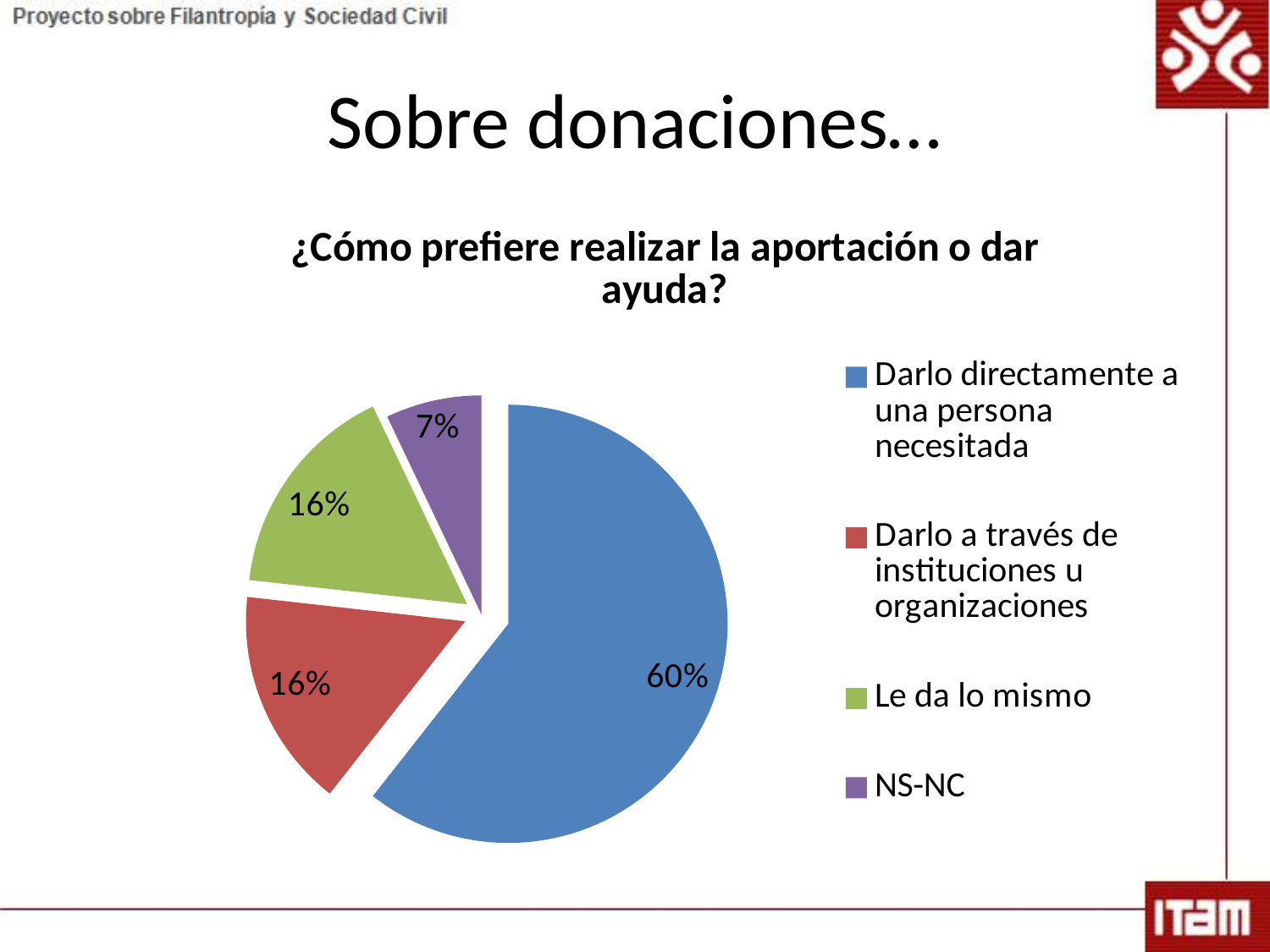
What is the difference in percentage points between 'Darlo directamente a una persona necesitada' and 'NS-NC'? 53 What share of the pie is 'Darlo directamente a una persona necesitada'? 60% What kind of chart is shown on the slide? pie chart Which category has the smallest slice of the pie? NS-NC What is the chart's title? ¿Cómo prefiere realizar la aportación o dar ayuda? How many slices does the pie chart have? 4 What share of the pie is 'Le da lo mismo'? 16% What share of the pie is 'Darlo a través de instituciones u organizaciones'? 16% Which is larger, the slice for 'Le da lo mismo' or the slice for 'NS-NC'? Le da lo mismo Which category has the largest slice of the pie? Darlo directamente a una persona necesitada What colour is the slice for 'Le da lo mismo'? green